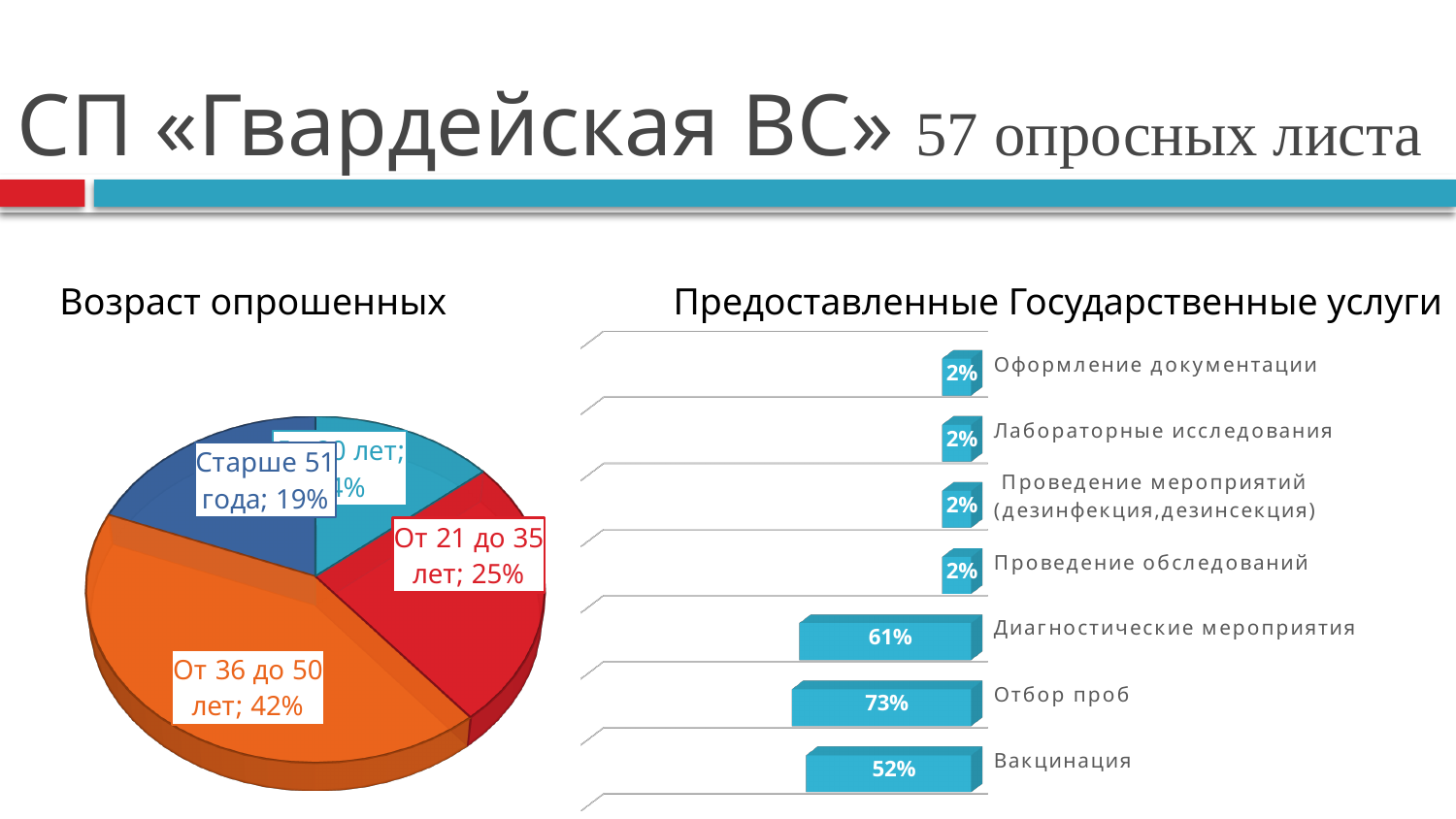
In the pie chart 'Возраст опрошенных', what share is shown for 'Старше 51 года'? 19% What type of chart is 'Возраст опрошенных'? Pie chart How many categories are shown in the chart 'Предоставленные Государственные услуги'? 7 In the chart 'Предоставленные Государственные услуги', what value is shown for 'Вакцинация'? 52% In the chart 'Предоставленные Государственные услуги', what is the difference between 'Отбор проб' and 'Диагностические мероприятия'? 12% In the pie chart 'Возраст опрошенных', how many percentage points larger is 'От 36 до 50 лет' than 'От 21 до 35 лет'? 17% How many slices does the pie chart 'Возраст опрошенных' have? 4 In the chart 'Предоставленные Государственные услуги', what value is shown for 'Отбор проб'? 73% In the pie chart 'Возраст опрошенных', which age group has the largest share? От 36 до 50 лет In the chart 'Предоставленные Государственные услуги', which service has the highest value? Отбор проб In the chart 'Предоставленные Государственные услуги', which is larger: 'Вакцинация' or 'Диагностические мероприятия'? Диагностические мероприятия In the pie chart 'Возраст опрошенных', what share is shown for 'От 36 до 50 лет'? 42%